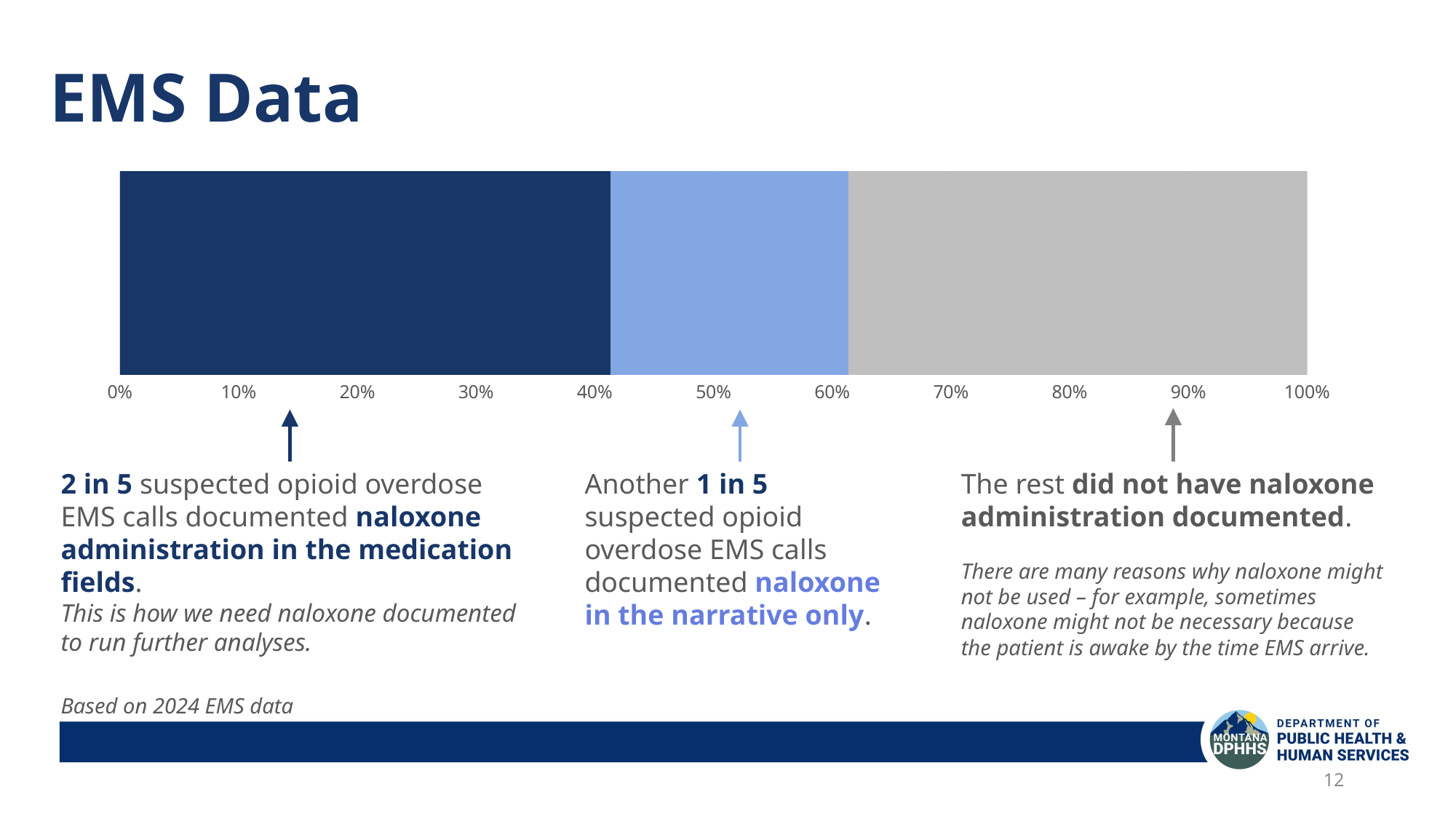
How many segments make up the stacked bar? 3 Is the width of the dark blue segment greater or less than 30%? greater Is the width of the light blue segment greater or less than 30%? less Does the boundary between the light blue and gray segments fall above or below 50% on the axis? above What colour is the segment representing calls that did not have naloxone administration documented? Gray What kind of chart is shown on the slide? Stacked bar chart How many tick labels are shown on the x axis? 11 What is the highest value shown on the x axis? 100% Which is larger: the dark blue segment or the light blue segment? The dark blue segment Which segment of the bar is the smallest? The light blue segment (naloxone in the narrative only)